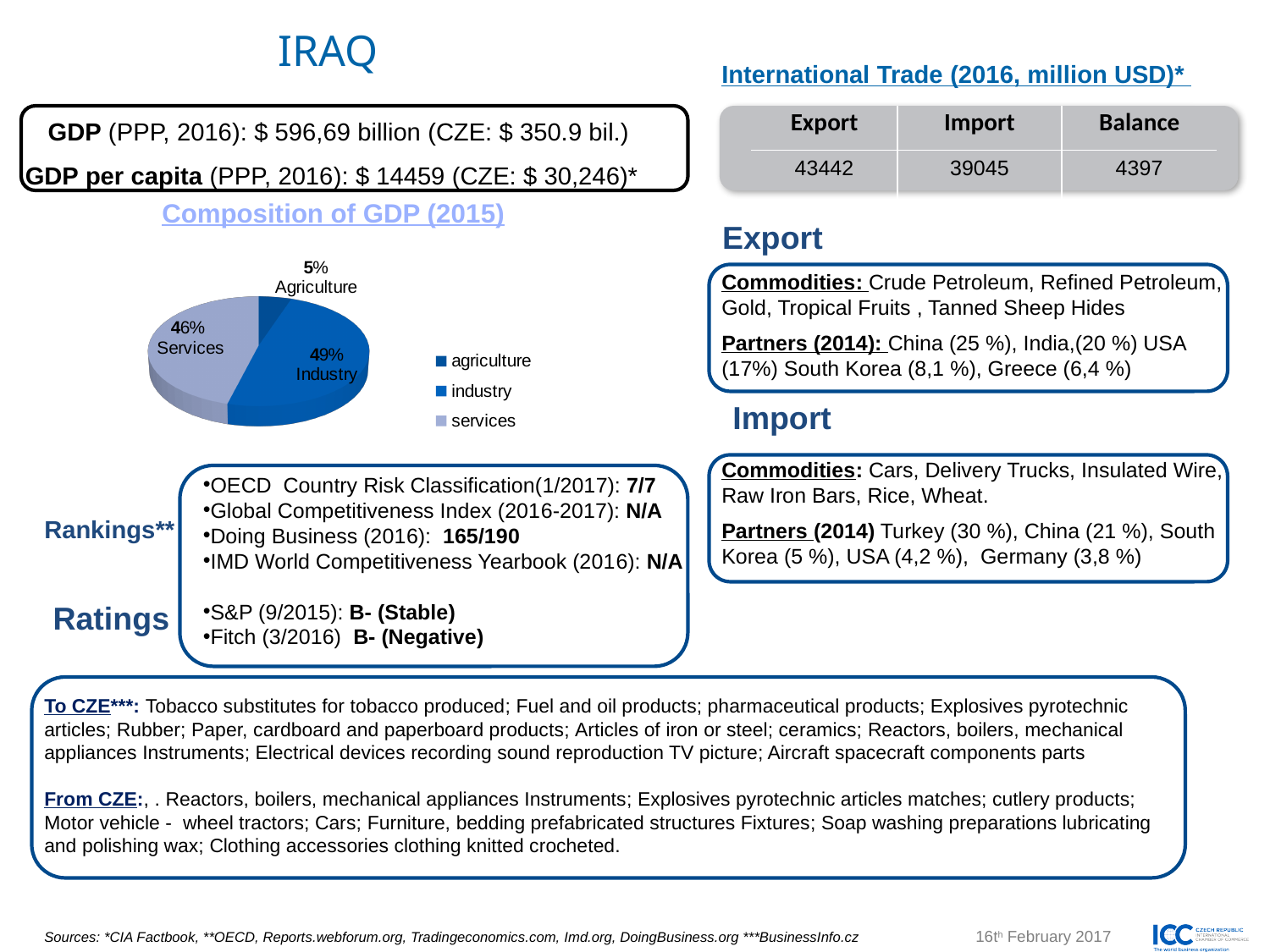
In the Composition of GDP (2015) chart, what is the difference in percentage points between the Services and Agriculture shares? 41 What share of GDP does Agriculture account for in the Composition of GDP (2015) chart? 5% How many entries does the legend of the Composition of GDP (2015) chart list? 3 Which sector has the largest share in the Composition of GDP (2015) chart? Industry What kind of chart is used to show the Composition of GDP (2015)? pie chart What share of GDP does Services account for in the Composition of GDP (2015) chart? 46% Which sector has the smallest share in the Composition of GDP (2015) chart? Agriculture In the Composition of GDP (2015) chart, what is the difference in percentage points between the Industry and Services shares? 3 How many sectors are shown in the Composition of GDP (2015) pie chart? 3 What share of GDP does Industry account for in the Composition of GDP (2015) chart? 49% In the Composition of GDP (2015) chart, which is larger: the share of Industry or the share of Agriculture? Industry What is the title of the pie chart on the slide? Composition of GDP (2015)